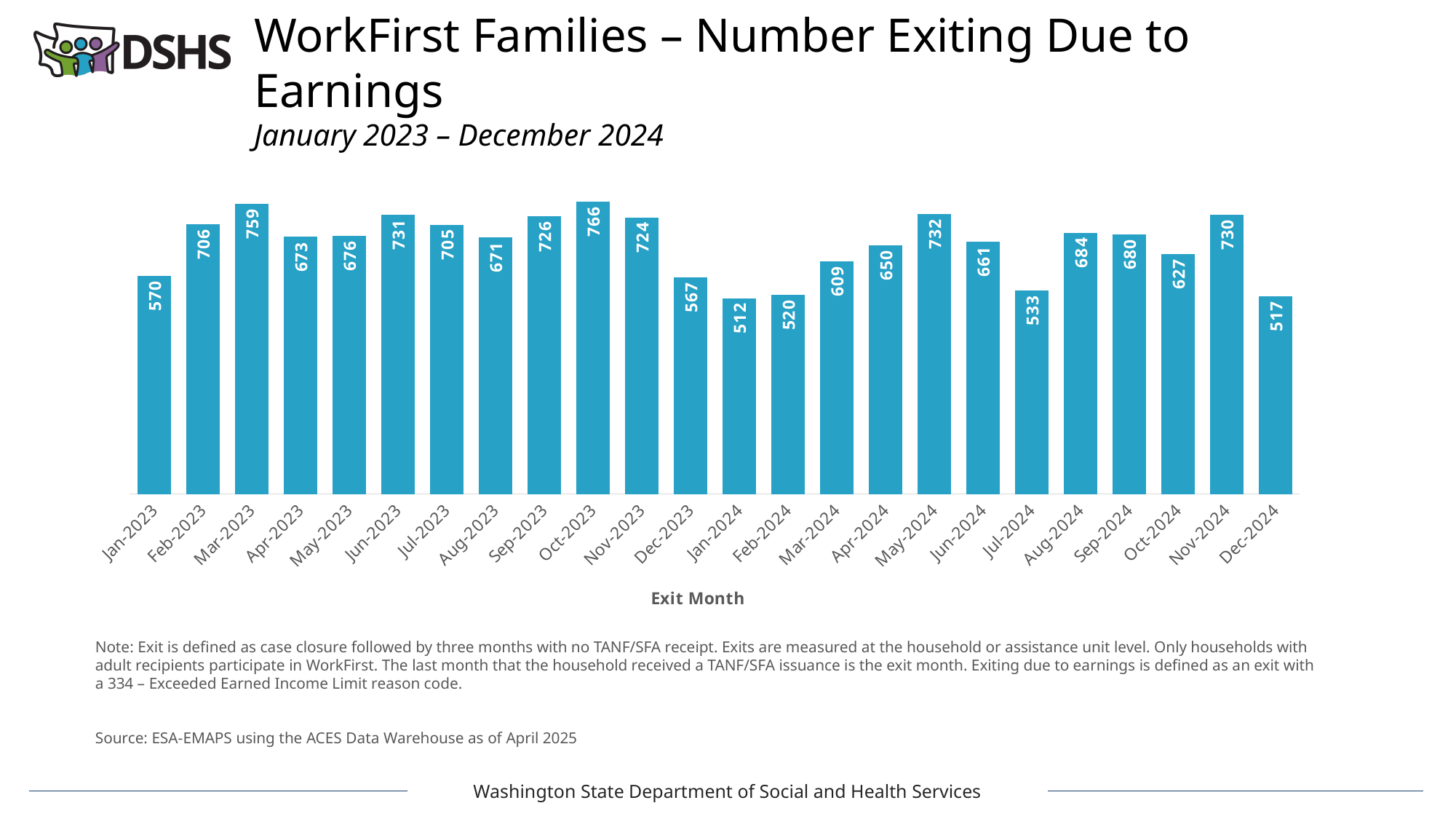
Which exit month has the lowest number of families exiting due to earnings? Jan-2024 Which is larger, the value for May-2024 or the value for Jun-2024? May-2024 What is the value shown for Jan-2024? 512 What is the number of WorkFirst families exiting due to earnings in Oct-2023? 766 How many exit months are shown on the chart? 24 What is the difference between the values for Nov-2024 and Dec-2024? 213 Which exit month has the highest number of families exiting due to earnings? Oct-2023 What is the difference between the values for Mar-2023 and Apr-2023? 86 What is the label of the x axis? Exit Month Which is larger, the value for Jan-2023 or the value for Dec-2023? Jan-2023 What kind of chart is shown on the slide? Bar chart What is the value shown for Dec-2024? 517